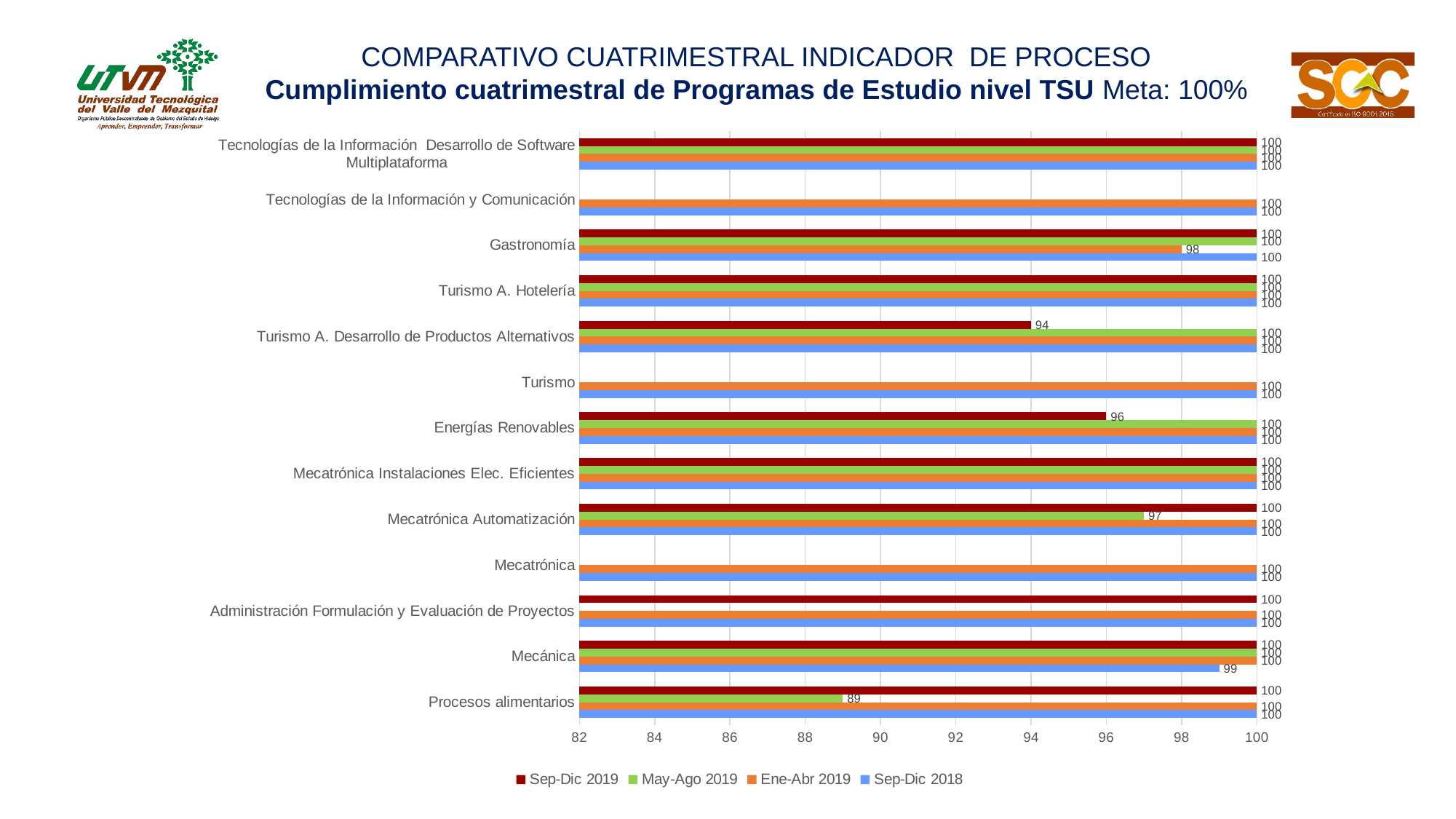
What is the May-Ago 2019 value for Mecatrónica Automatización? 97 What is the Sep-Dic 2018 value for Mecánica? 99 Which is larger for Energías Renovables: the Sep-Dic 2019 value or the May-Ago 2019 value? May-Ago 2019 What is the Sep-Dic 2019 value for Turismo A. Desarrollo de Productos Alternativos? 94 What type of chart is shown on the slide? bar chart How many program categories are shown on the y axis? 13 What is the May-Ago 2019 value for Procesos alimentarios? 89 What is the difference between the Sep-Dic 2019 value (100) and the May-Ago 2019 value for Procesos alimentarios? 11 What is the Ene-Abr 2019 value for Gastronomía? 98 What is the Sep-Dic 2019 value for Energías Renovables? 96 How many series does the legend list? 4 Which category has the lowest May-Ago 2019 value? Procesos alimentarios